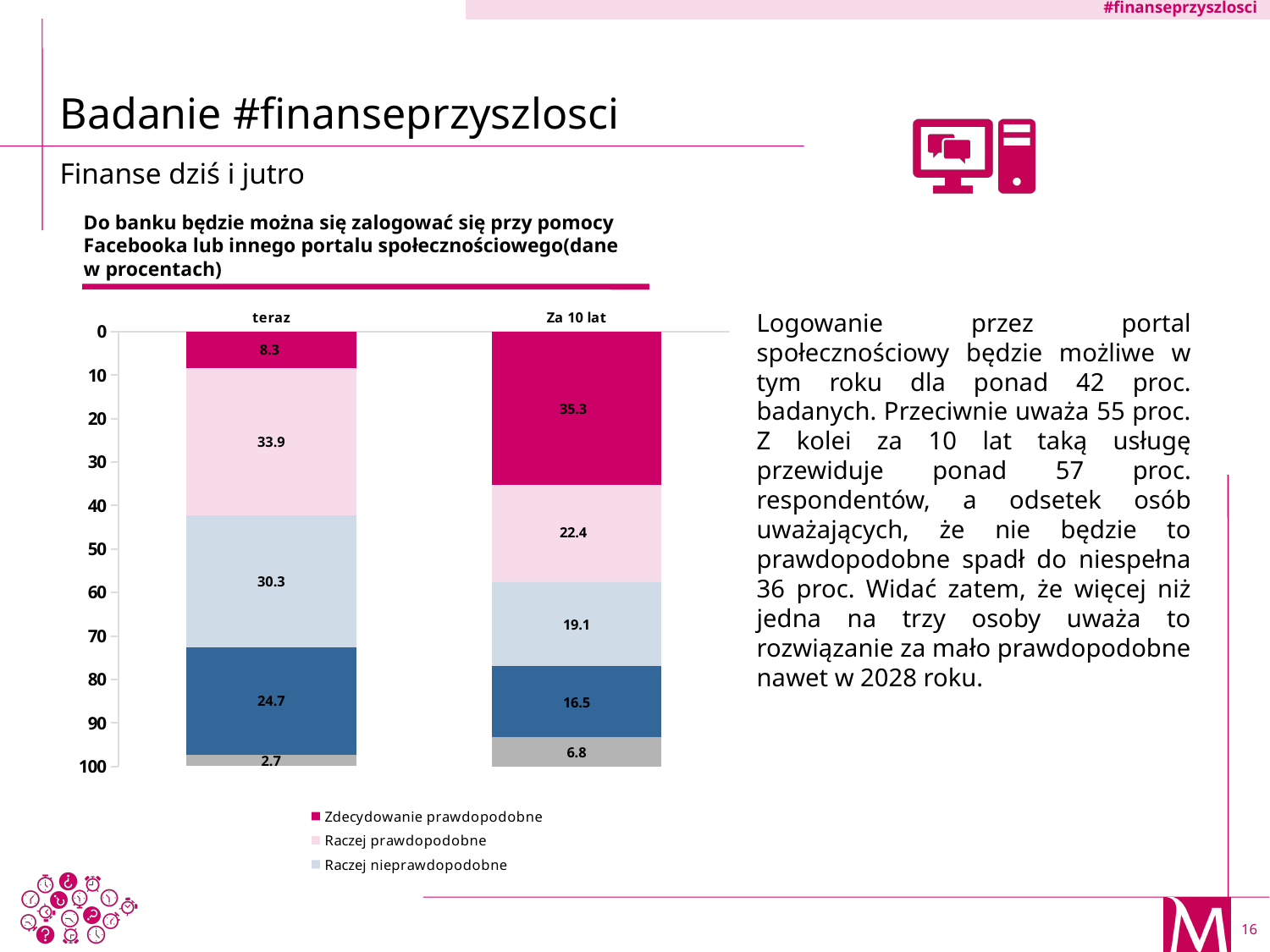
How many series does the chart's legend list? 3 What is the difference between the Raczej nieprawdopodobne values for teraz and Za 10 lat? 11.2 Which category has the larger Raczej prawdopodobne value, teraz or Za 10 lat? teraz What is the value of Raczej prawdopodobne for teraz? 33.9 What is the total of all segments in the teraz bar? 99.9 What is the value of Zdecydowanie prawdopodobne for teraz? 8.3 Which category has the higher Zdecydowanie prawdopodobne value? Za 10 lat What is the difference between the Zdecydowanie prawdopodobne values for Za 10 lat and teraz? 27 How many categories are shown on the x axis of the chart? 2 What is the value of Zdecydowanie prawdopodobne for Za 10 lat? 35.3 What is the value of Raczej nieprawdopodobne for Za 10 lat? 19.1 What kind of chart is shown on the slide? stacked bar chart